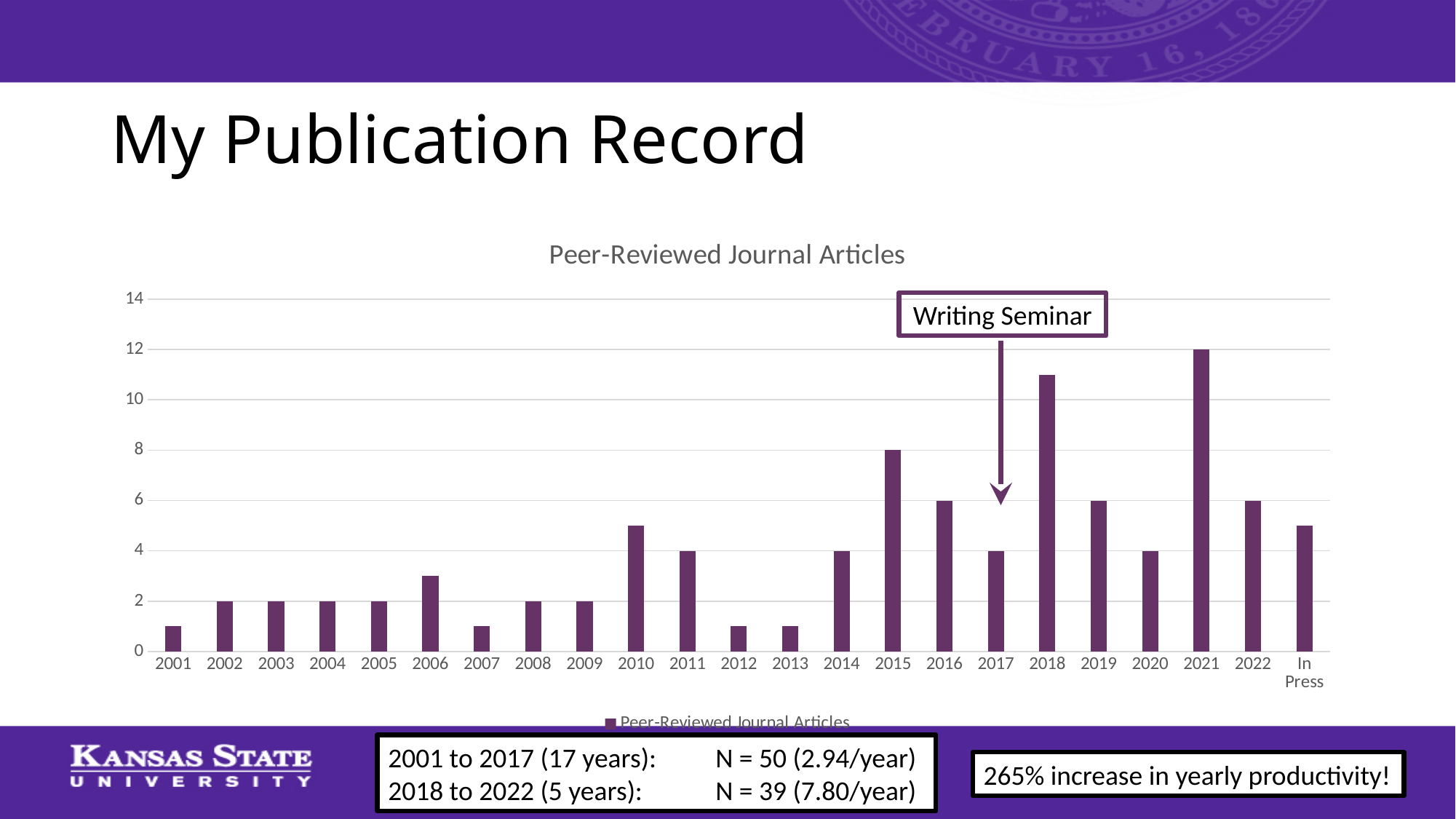
What is the title of the chart? Peer-Reviewed Journal Articles Which is larger, the value for 2018 or the value for 2015? 2018 Which year has the highest number of peer-reviewed journal articles? 2021 How many peer-reviewed journal articles are shown for 2015? 8 How many series does the legend list? 1 Is the value for 2018 greater or less than 10? greater How many categories are shown on the x axis? 23 What is the difference between the values for 2021 and 2015? 4 What type of chart is shown on the slide? Bar chart How many peer-reviewed journal articles are shown for 2021? 12 Is the value for 2006 greater or less than 4? less How many peer-reviewed journal articles are shown for 2016? 6